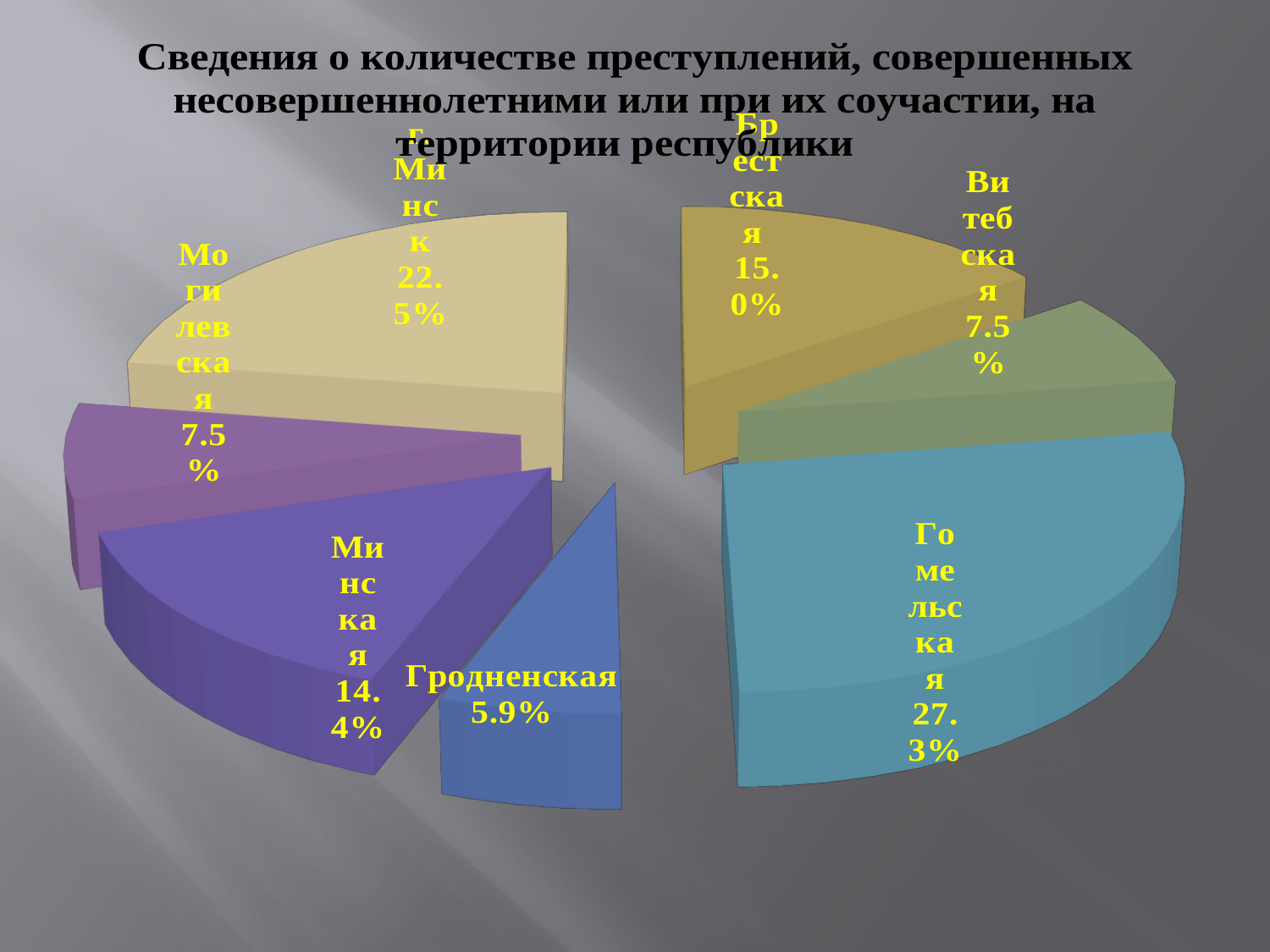
What is the difference in percentage points between Гомельская and Минск? 4.8 What type of chart is shown on the slide? Pie chart What is the value shown for Гродненская? 5.9% What is the value shown for Минская? 14.4% What is the value shown for Брестская? 15.0% Which is larger, the slice for Минская or the slice for Брестская? Брестская How many slices does the pie chart have? 7 What is the value shown for Минск? 22.5% Which region has the largest slice of the pie? Гомельская What share of the pie does Гомельская have? 27.3% What is the title of the chart? Сведения о количестве преступлений, совершенных несовершеннолетними или при их соучастии, на территории республики Which region has the smallest slice of the pie? Гродненская